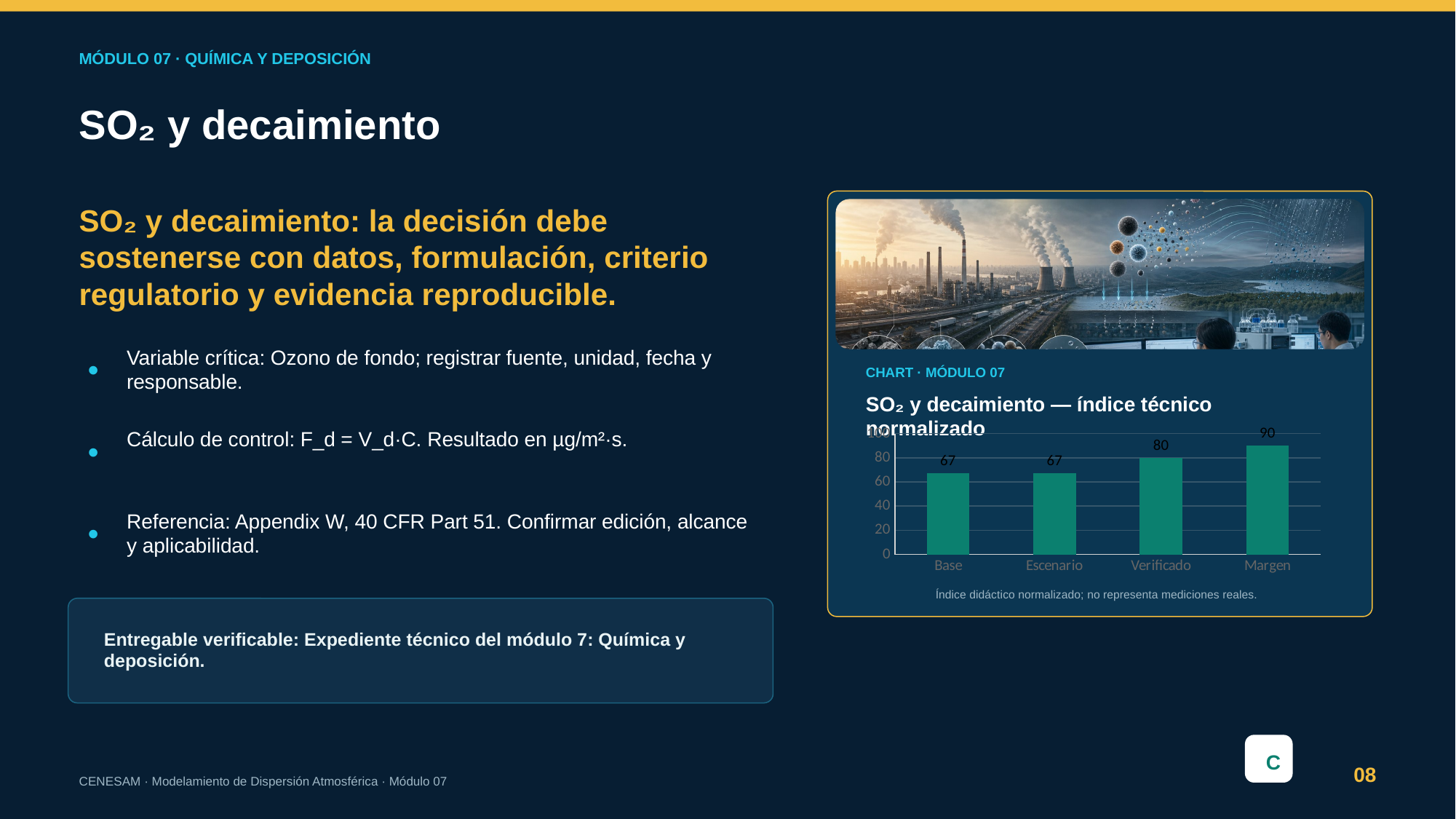
What is the difference between the values for Verificado and Base? 13 How many categories are shown on the x axis? 4 What is the difference between the values for Margen and Verificado? 10 Which category has the highest value? Margen What is the value for Escenario? 67 Is the value for Margen greater or less than 80? greater What is the value for Margen? 90 What kind of chart is shown on the slide? bar chart What is the title of the chart? SO₂ y decaimiento — índice técnico normalizado What is the value for Base? 67 What is the value for Verificado? 80 Which is larger, the value for Verificado or the value for Escenario? Verificado